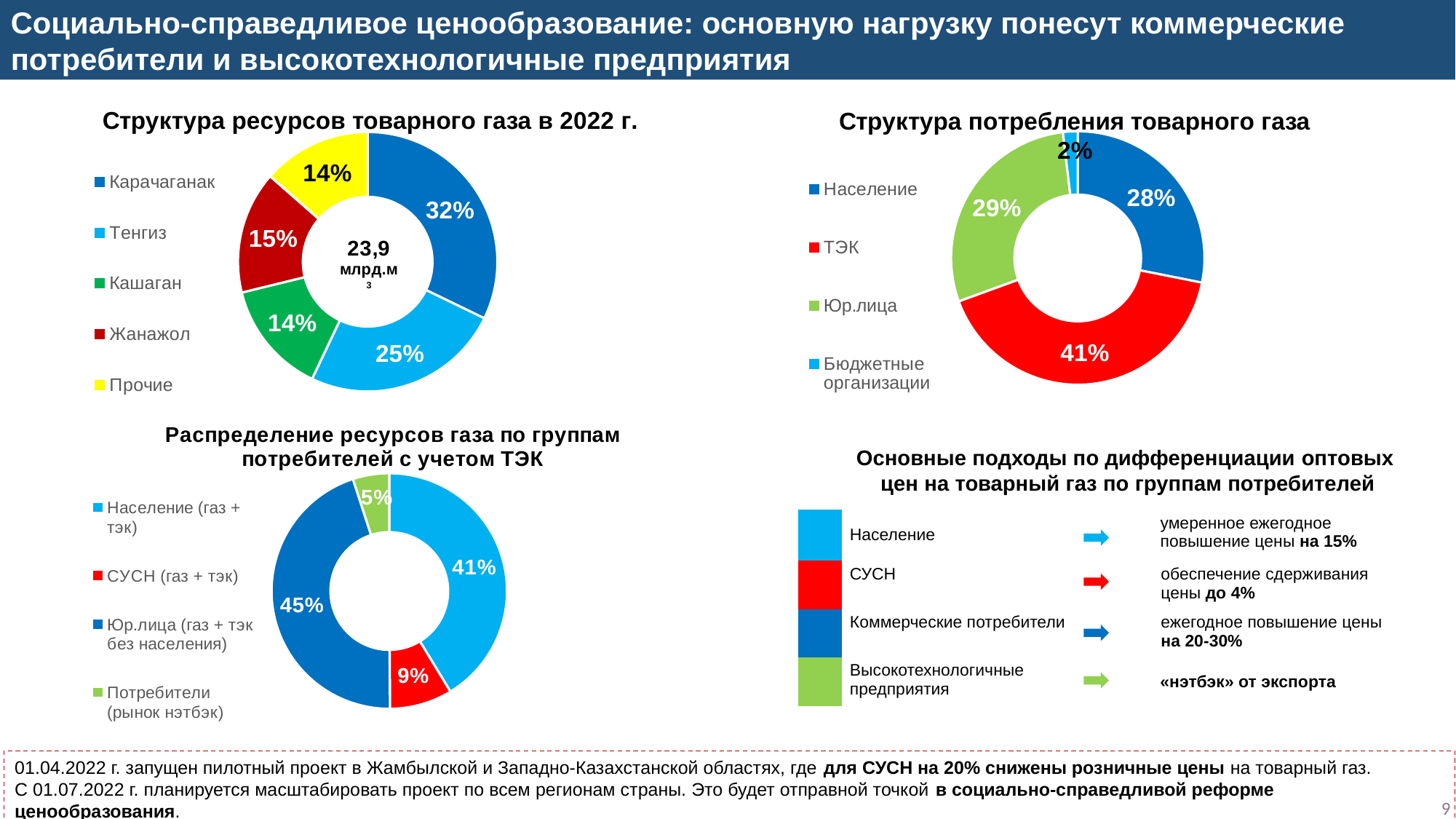
In the chart 'Структура потребления товарного газа', what type of chart is used? Pie (donut) chart In the chart 'Структура ресурсов товарного газа в 2022 г.', what share does Карачаганак have? 32% In the chart 'Структура потребления товарного газа', which is larger: Население or Юр.лица? Юр.лица In the chart 'Структура потребления товарного газа', which category has the smallest share? Бюджетные организации In the chart 'Распределение ресурсов газа по группам потребителей с учетом ТЭК', which category has the largest share? Юр.лица (газ + тэк без населения) In the chart 'Распределение ресурсов газа по группам потребителей с учетом ТЭК', what share does СУСН (газ + тэк) have? 9% In the chart 'Структура потребления товарного газа', what share does ТЭК have? 41% In the chart 'Структура ресурсов товарного газа в 2022 г.', how many categories does the legend list? 5 In the chart 'Структура ресурсов товарного газа в 2022 г.', what total volume is shown in the centre of the donut? 23,9 млрд.м3 In the chart 'Распределение ресурсов газа по группам потребителей с учетом ТЭК', what is the difference between the shares of Население (газ + тэк) and Потребители (рынок нэтбэк)? 36% In the chart 'Структура ресурсов товарного газа в 2022 г.', which category has the largest share? Карачаганак In the chart 'Структура ресурсов товарного газа в 2022 г.', what is the difference between the shares of Тенгиз and Жанажол? 10%